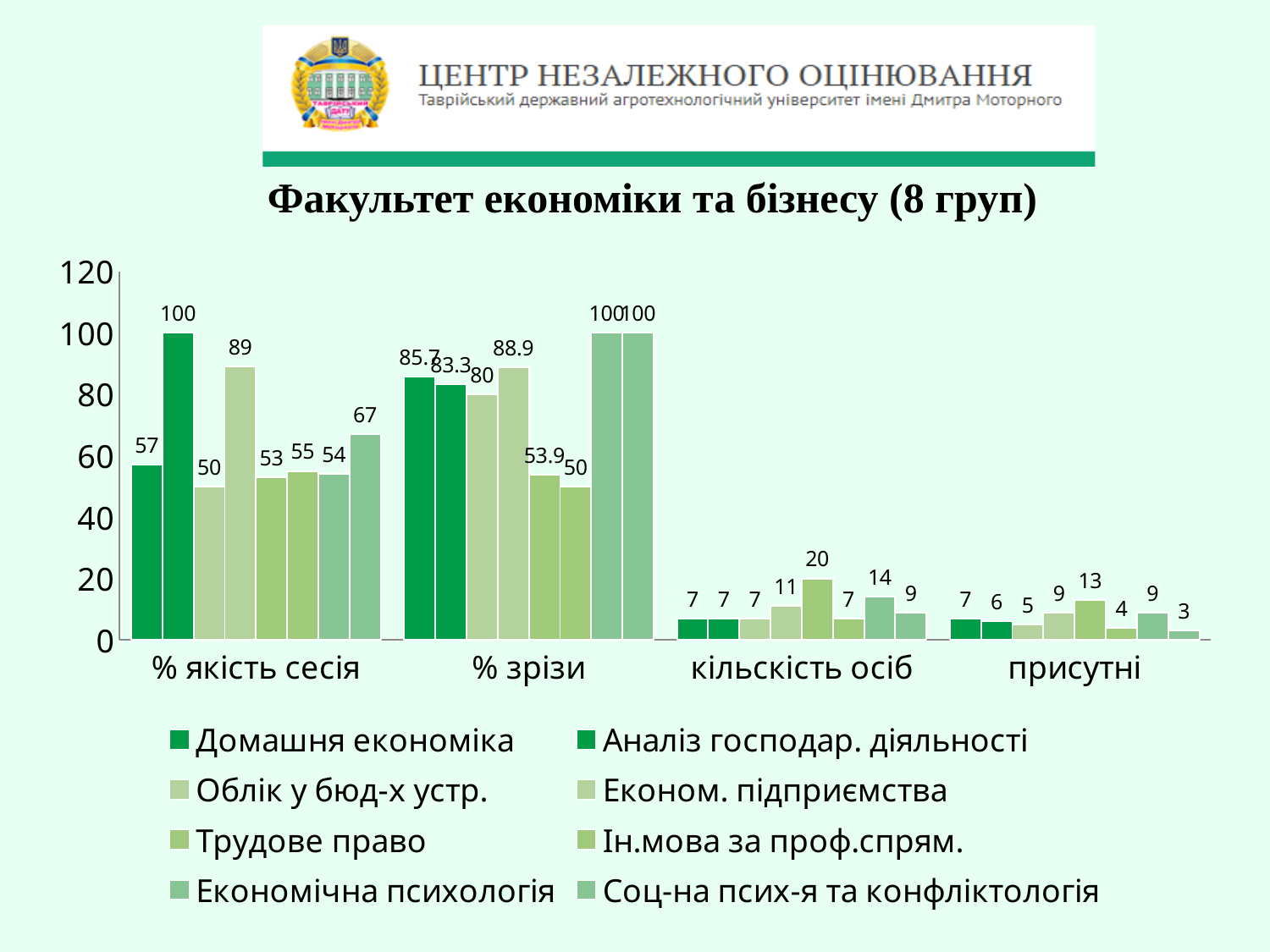
Which series has the lowest value in the присутні category? Соц-на псих-я та конфліктологія What is the difference between the values for Економ. підприємства and Домашня економіка in the % якість сесія category? 32 What type of chart is shown on the slide? bar chart What is the value for Економ. підприємства in the % зрізи category? 88.9 What is the difference between the кільскість осіб and присутні values for Економічна психологія? 5 What is the value for Аналіз господар. діяльності in the % якість сесія category? 100 What is the title of the chart? Факультет економіки та бізнесу (8 груп) In the % зрізи category, which is larger: the value for Домашня економіка or the value for Трудове право? Домашня економіка What is the value for Трудове право in the кільскість осіб category? 20 How many series does the legend list? 8 Which series has the highest value in the присутні category? Трудове право How many categories are shown on the x axis? 4